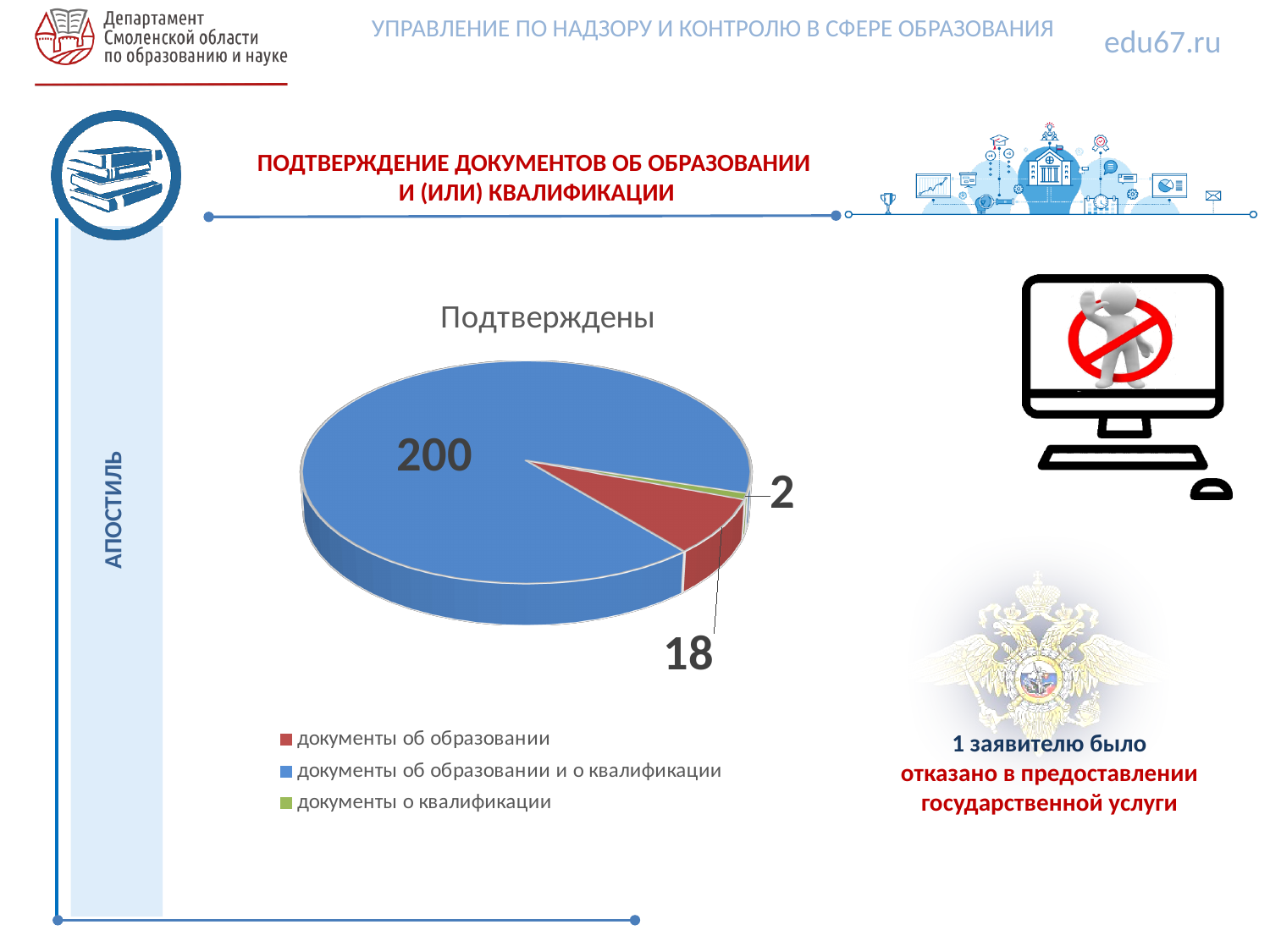
What is the value for 'документы об образовании и о квалификации' in the pie chart? 200 What is the total of all values shown in the pie chart? 220 What type of chart is shown on the slide? pie chart What is the value for 'документы об образовании' in the pie chart? 18 Which is larger: the value for 'документы об образовании' or for 'документы о квалификации'? документы об образовании Which category has the smallest slice in the pie chart? документы о квалификации What is the value for 'документы о квалификации' in the pie chart? 2 What is the title of the pie chart? Подтверждены What is the difference between the values for 'документы об образовании и о квалификации' and 'документы об образовании'? 182 How many slices does the pie chart have? 3 How many entries does the legend of the pie chart list? 3 Which category has the largest slice in the pie chart? документы об образовании и о квалификации